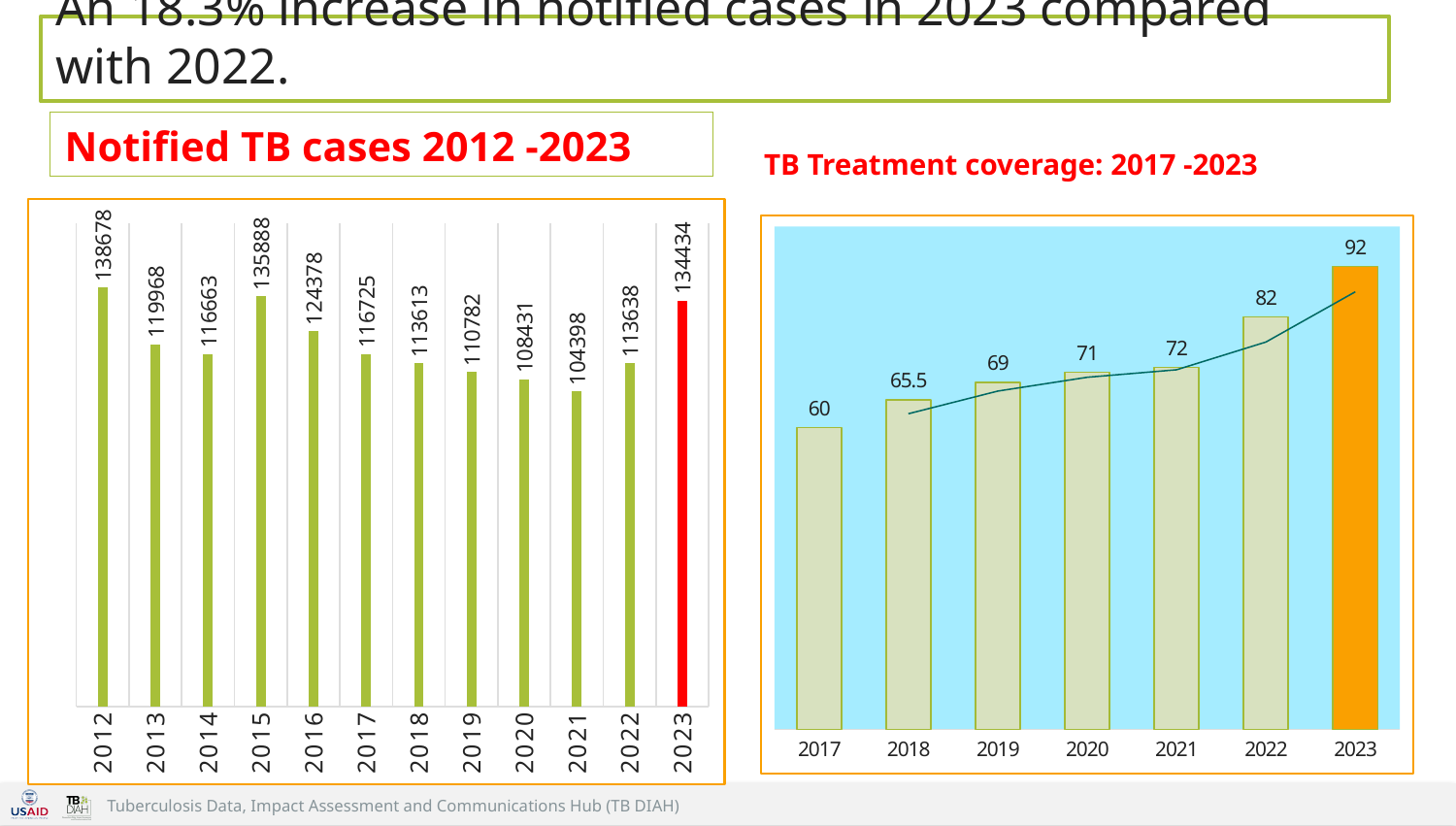
In the 'TB Treatment coverage: 2017 -2023' chart, what is the value for 2023? 92 In the 'Notified TB cases 2012 -2023' chart, how many years are shown on the x axis? 12 In the 'TB Treatment coverage: 2017 -2023' chart, what is the difference between the 2022 value and the 2021 value? 10 What kind of chart is the 'TB Treatment coverage: 2017 -2023' chart? bar chart with a line In the 'Notified TB cases 2012 -2023' chart, which year has the highest number of notified cases? 2012 In the 'Notified TB cases 2012 -2023' chart, what is the difference between the 2023 value and the 2022 value? 20796 In the 'TB Treatment coverage: 2017 -2023' chart, do the values rise or fall from 2017 to 2023? rise In the 'Notified TB cases 2012 -2023' chart, which year has the lowest number of notified cases? 2021 In the 'Notified TB cases 2012 -2023' chart, what is the value for 2021? 104398 In the 'TB Treatment coverage: 2017 -2023' chart, what is the value for 2018? 65.5 In the 'Notified TB cases 2012 -2023' chart, which bar is coloured red? 2023 In the 'Notified TB cases 2012 -2023' chart, what is the value for 2023? 134434